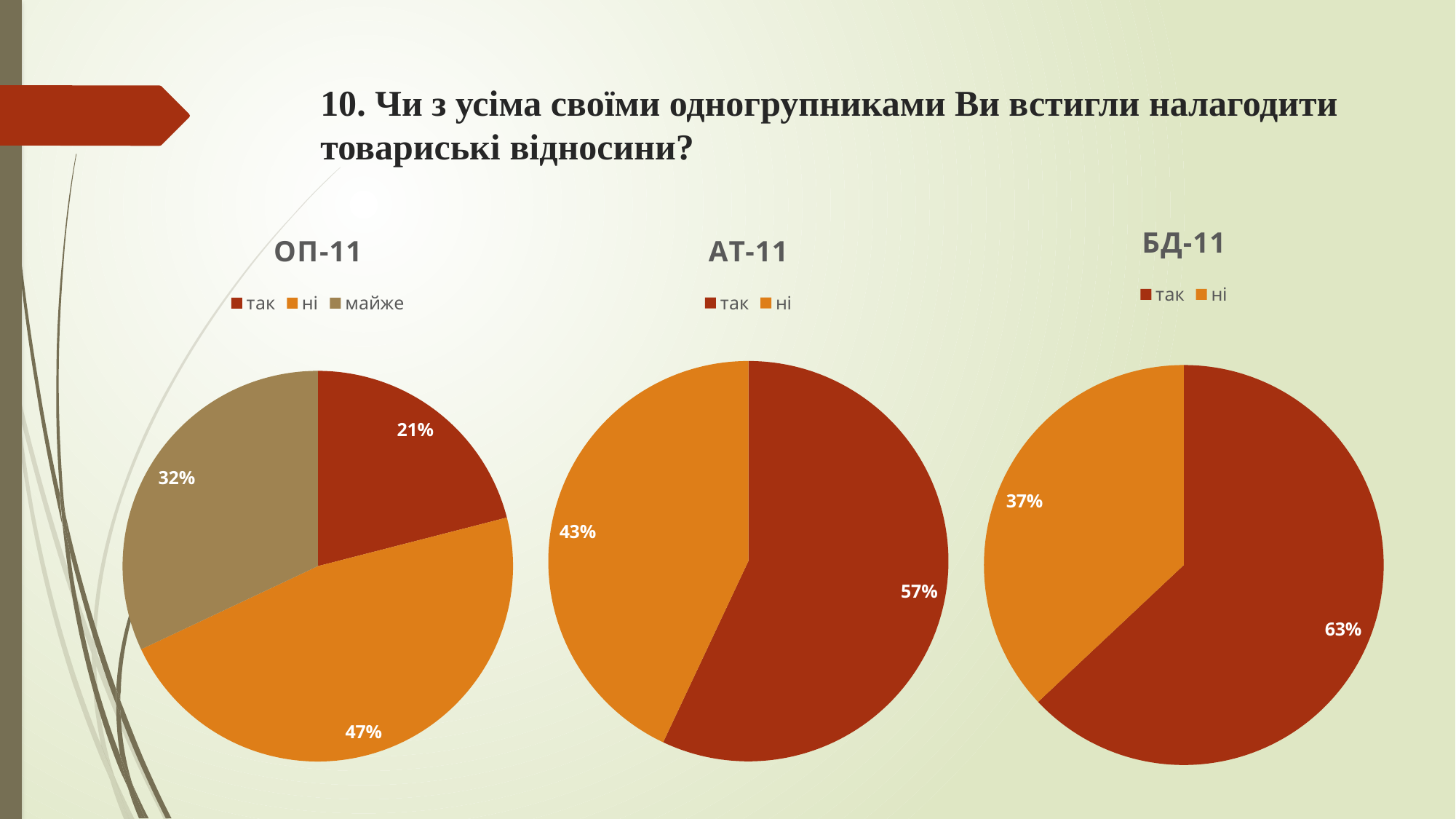
In the БД-11 chart, how many entries does the legend list? 2 In the АТ-11 chart, what is the difference between the 'так' and 'ні' shares? 14% In the ОП-11 chart, how many slices does the pie have? 3 Which chart on the slide includes a 'майже' category in its legend? ОП-11 In the БД-11 chart, what share is labelled for 'ні'? 37% In the ОП-11 chart, which category has the smallest slice? так In the БД-11 chart, which is larger, 'так' or 'ні'? так In the ОП-11 chart, which category has the largest slice? ні What type of chart is the АТ-11 chart? pie chart In the ОП-11 chart, what share is labelled for 'так'? 21% In the ОП-11 chart, what share is labelled for 'майже'? 32% In the АТ-11 chart, what share is labelled for 'так'? 57%